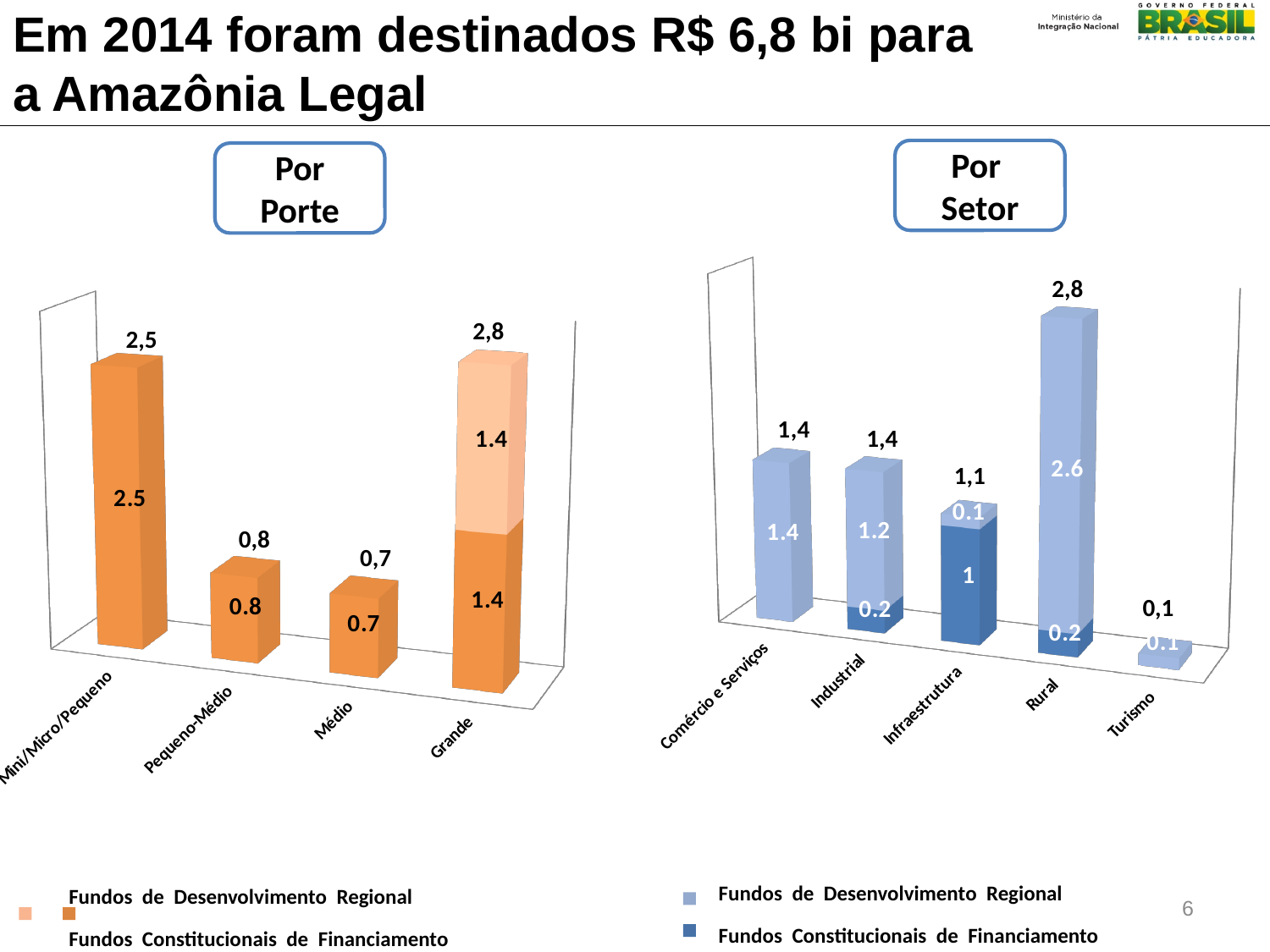
In the 'Por Setor' chart, what is the difference between the total for Rural and the total for Turismo? 2,7 What kind of chart is the 'Por Setor' chart? Stacked bar chart In the 'Por Setor' chart, what is the Fundos Constitucionais de Financiamento segment of the Infraestrutura bar? 1 In the 'Por Porte' chart, what is the Fundos de Desenvolvimento Regional segment of the Grande bar? 1.4 In the 'Por Setor' chart, which is larger: the total for Industrial or the total for Infraestrutura? Industrial In the 'Por Setor' chart, how many series does the legend list? 2 In the 'Por Porte' chart, what is the value for Pequeno-Médio? 0,8 In the 'Por Porte' chart, what is the total value shown above the Grande bar? 2,8 In the 'Por Setor' chart, what is the total value shown above the Infraestrutura bar? 1,1 In the 'Por Setor' chart, which sector has the highest total value? Rural In the 'Por Porte' chart, which category has the lowest value? Médio In the 'Por Porte' chart, how many categories are shown on the x axis? 4